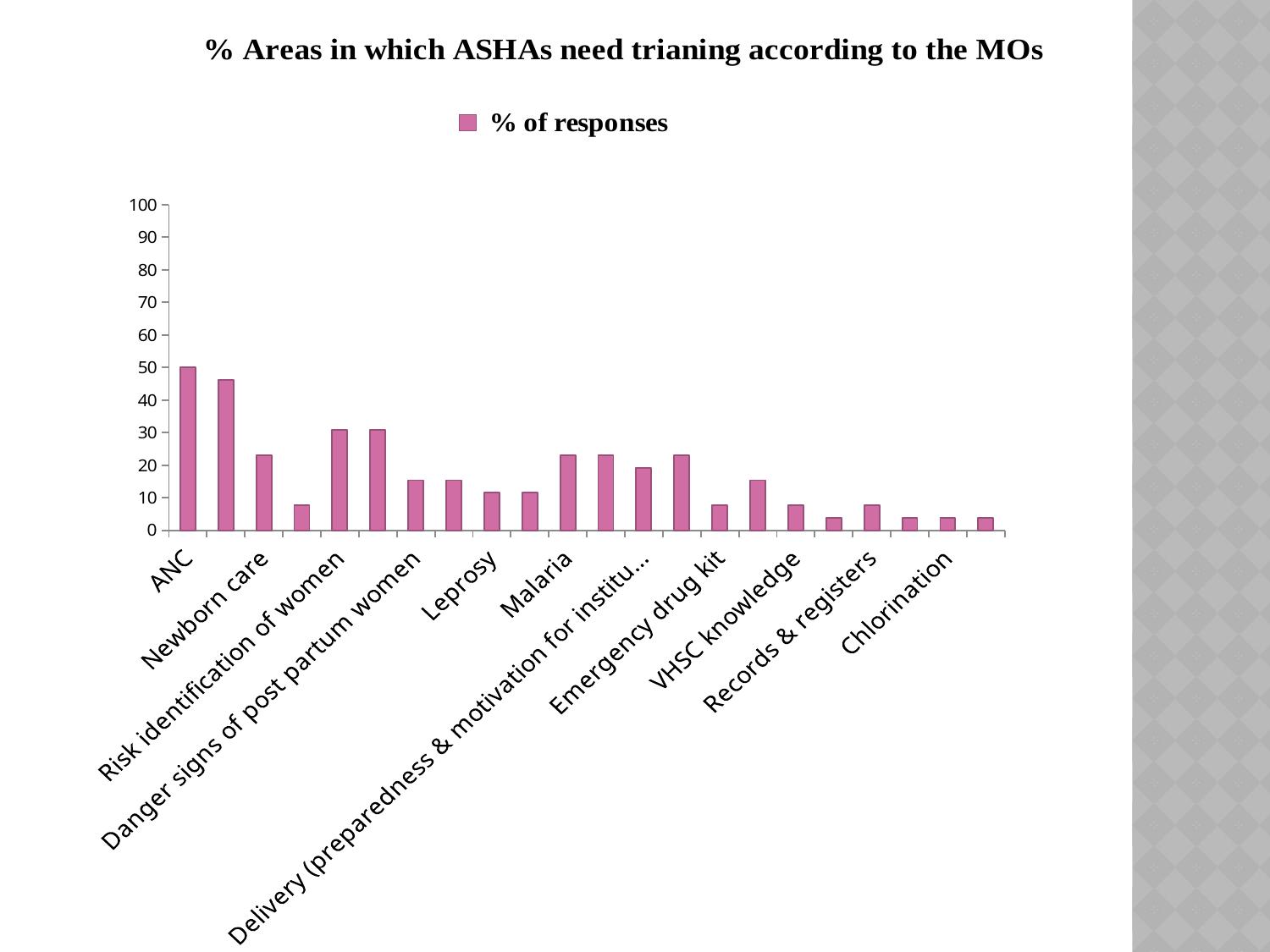
Is the value for Leprosy greater or less than 20? less Is the value for Risk identification of women greater or less than 20? greater Do the values generally rise or fall from left to right along the x axis? fall Is the value for ANC greater or less than 40? greater What is the title of the chart? % Areas in which ASHAs need trianing according to the MOs How many series does the legend list? 1 Which is larger, the value for Malaria or the value for Leprosy? Malaria Which is larger, the value for ANC or the value for Newborn care? ANC What kind of chart is shown on the slide? Bar chart What is the name of the series shown in the legend? % of responses Which labelled category has the highest value? ANC